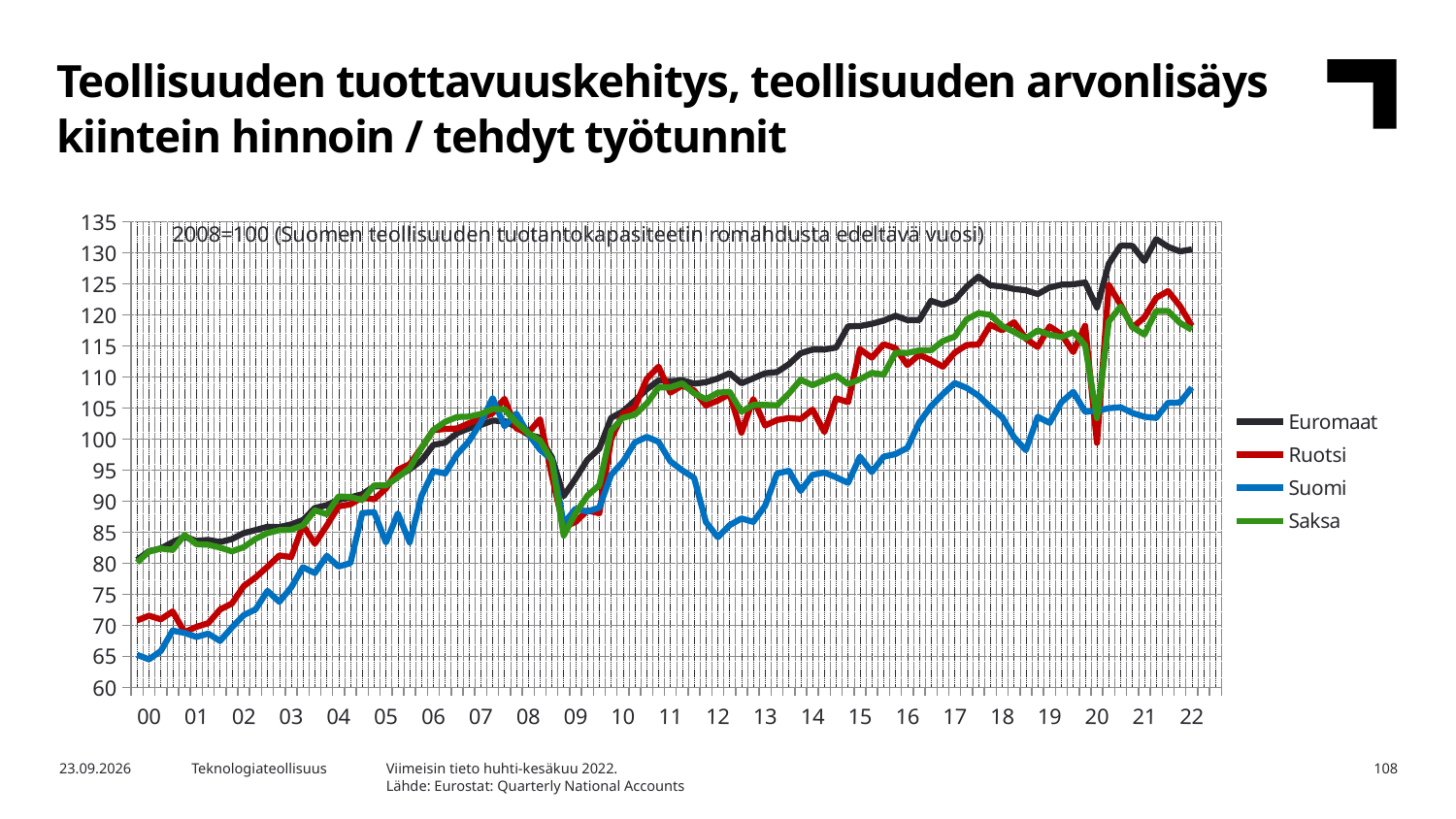
Which base year is set to 100 according to the note in the chart? 2008 Which series has the lowest value at the start of the chart (2000)? Suomi What kind of chart is shown on the slide? line chart Is the value for Euromaat in 2022 greater or less than 125? greater Which is larger in 2022, the value for Saksa or the value for Suomi? Saksa Which series are listed in the legend? Euromaat, Ruotsi, Suomi, Saksa How many series does the legend list? 4 Is the value for Suomi in 2000 greater or less than 70? less Which series has the highest value at the end of the chart (2022)? Euromaat Does the Euromaat series rise or fall overall from 2000 to 2022? rise Which series has the lowest value at the end of the chart (2022)? Suomi